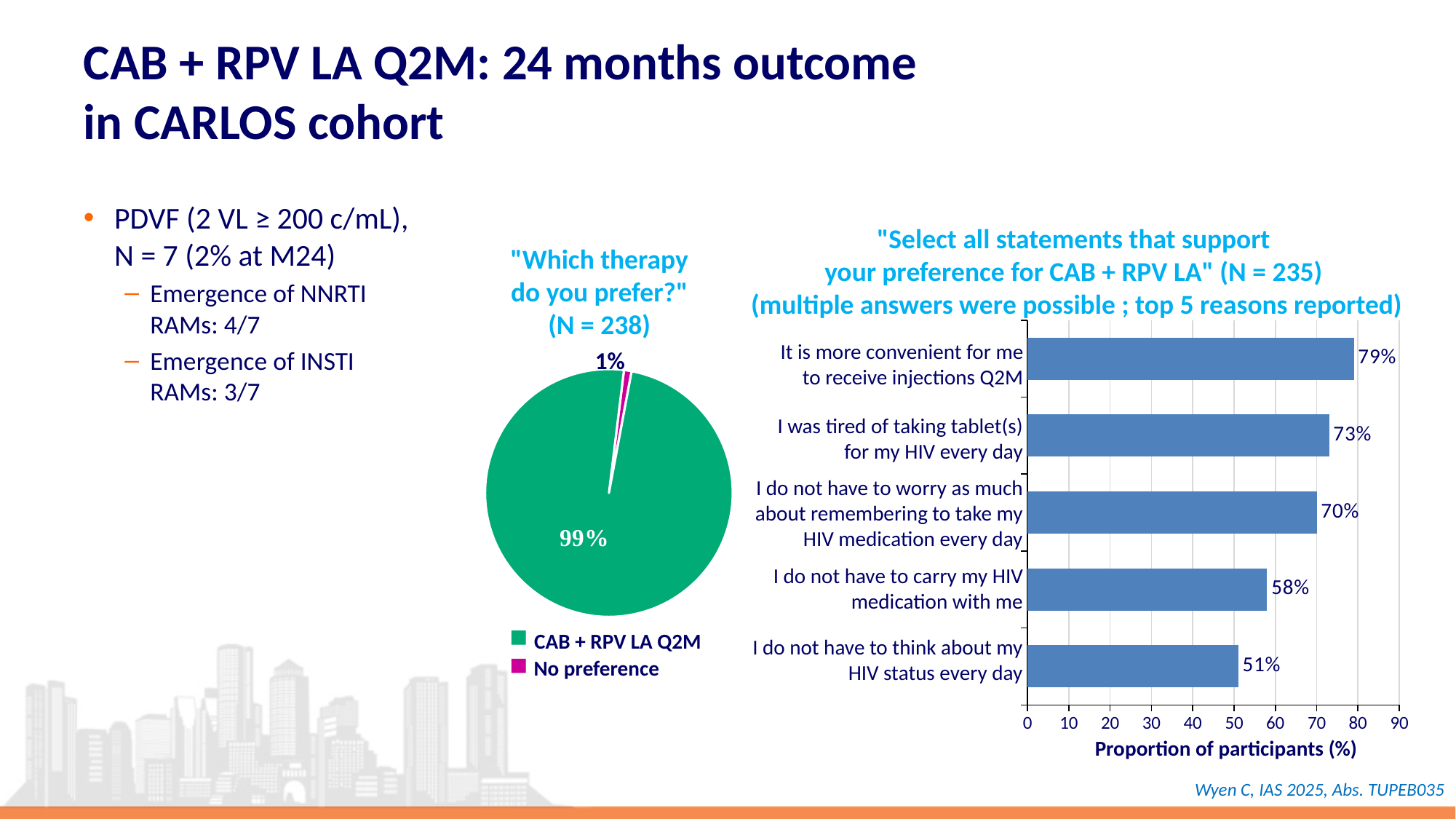
In the "Select all statements" bar chart, which statement has the lowest proportion of participants? I do not have to think about my HIV status every day In the "Select all statements" bar chart, what is the difference in percentage points between "I was tired of taking tablet(s) for my HIV every day" and "I do not have to think about my HIV status every day"? 22 In the "Which therapy do you prefer?" pie chart, what share of participants had no preference? 1% In the "Select all statements" bar chart, how many statements (bars) are shown? 5 In the "Which therapy do you prefer?" pie chart, what share of participants preferred CAB + RPV LA Q2M? 99% How many slices does the "Which therapy do you prefer?" pie chart have? 2 In the "Select all statements" bar chart, which statement has the highest proportion of participants? It is more convenient for me to receive injections Q2M What type of chart is the "Select all statements that support your preference for CAB + RPV LA" chart? Bar chart In the "Select all statements" bar chart, what proportion of participants selected "I do not have to carry my HIV medication with me"? 58% In the "Select all statements" bar chart, what proportion of participants selected "It is more convenient for me to receive injections Q2M"? 79% What type of chart is the "Which therapy do you prefer?" chart? Pie chart What is the x-axis label of the "Select all statements" bar chart? Proportion of participants (%)